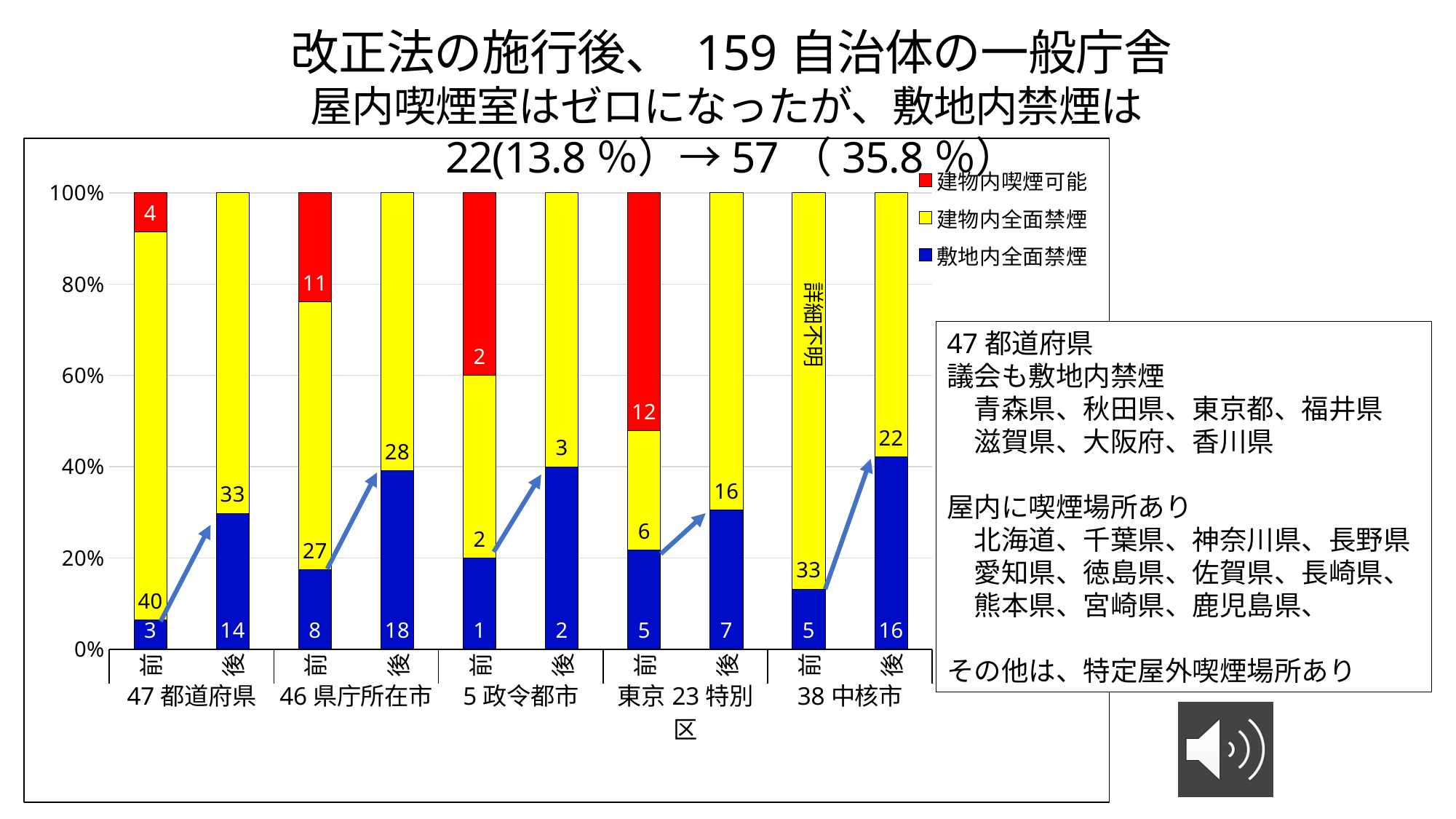
What is the 敷地内全面禁煙 value for 38 中核市 後? 16 What is the total of the stacked bar for 47 都道府県 前? 47 What is the 建物内全面禁煙 value for 東京 23 特別区 後? 16 What is the 敷地内全面禁煙 value for 47 都道府県 後? 14 How many series does the legend list? 3 How many bars are plotted in the chart? 10 What is the difference between the 敷地内全面禁煙 values for 47 都道府県 後 and 47 都道府県 前? 11 What type of chart is shown on the slide? stacked bar chart Which is larger, the 敷地内全面禁煙 value for 46 県庁所在市 後 or for 38 中核市 後? 46 県庁所在市 後 What is the 建物内喫煙可能 value for 46 県庁所在市 前? 11 Among the 後 bars, which group has the highest 敷地内全面禁煙 value? 46 県庁所在市